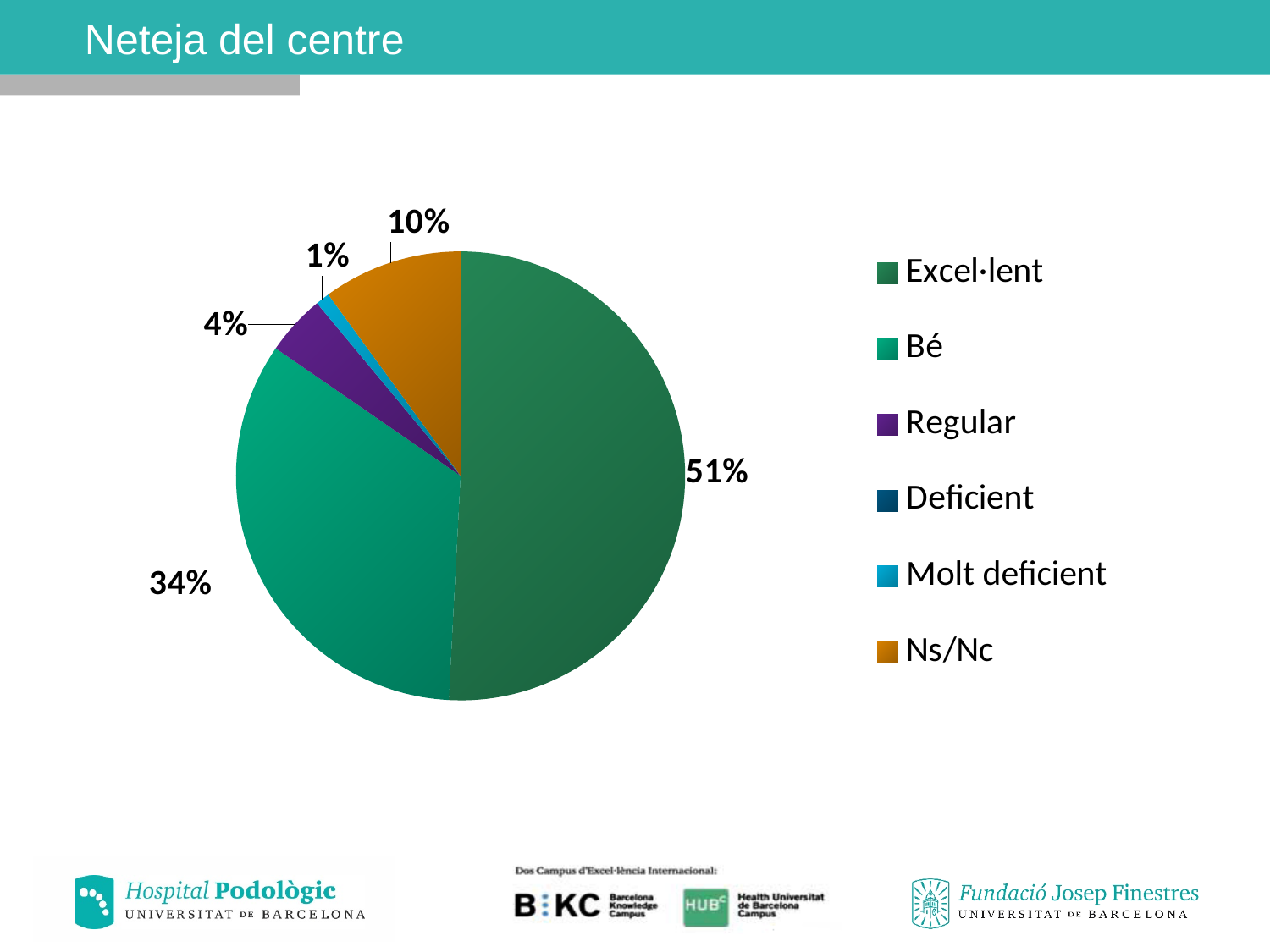
What percentage is shown for Regular? 4% What is the difference in percentage points between Excel·lent and Bé? 17 What is the title of the slide? Neteja del centre What is the combined share of Excel·lent and Bé? 85% Which is larger, the share for Ns/Nc or the share for Regular? Ns/Nc How many entries does the legend list? 6 What percentage is shown for Ns/Nc? 10% What share of the pie does Bé represent? 34% What percentage is shown for Molt deficient? 1% What kind of chart is shown on the slide? Pie chart Which category has the largest slice of the pie? Excel·lent What share of the pie does Excel·lent represent? 51%